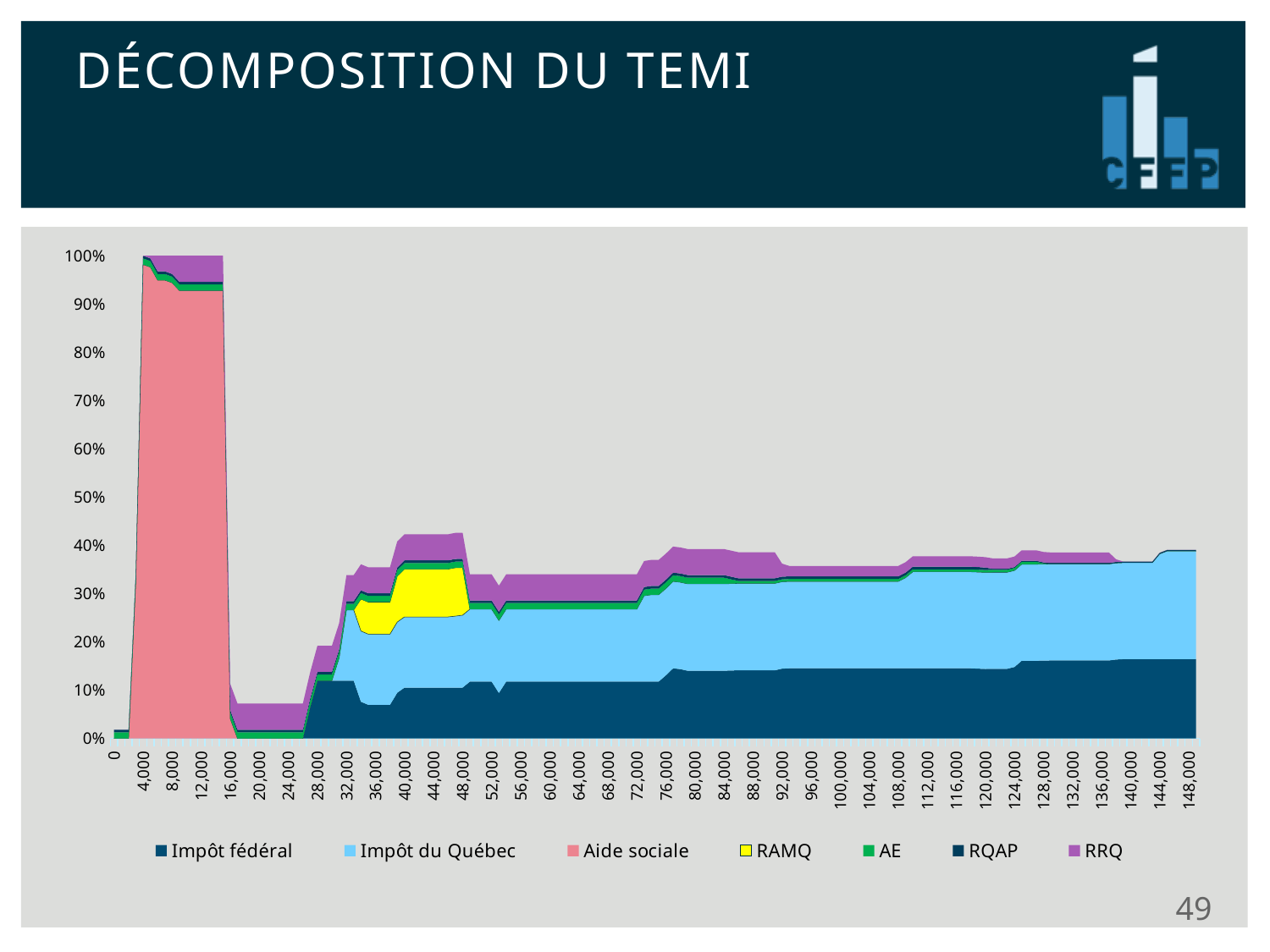
Is the total stacked value at an income of 20,000 greater or less than 10%? less What is the highest value shown on the vertical axis? 100% Does the total stacked value generally rise or fall as income increases from 28,000 to 148,000? rise Which series makes up almost all of the stacked total between incomes of 4,000 and 12,000? Aide sociale Which series is shown in yellow in the chart? RAMQ Is the total stacked value larger at an income of 8,000 or at an income of 100,000? 8,000 Is the total stacked value at an income of 8,000 greater or less than 90%? greater How many series does the legend list? 7 What is the title of the slide containing the chart? DÉCOMPOSITION DU TEMI What kind of chart is shown on the slide? stacked area chart Is the total stacked value at an income of 148,000 greater or less than 50%? less